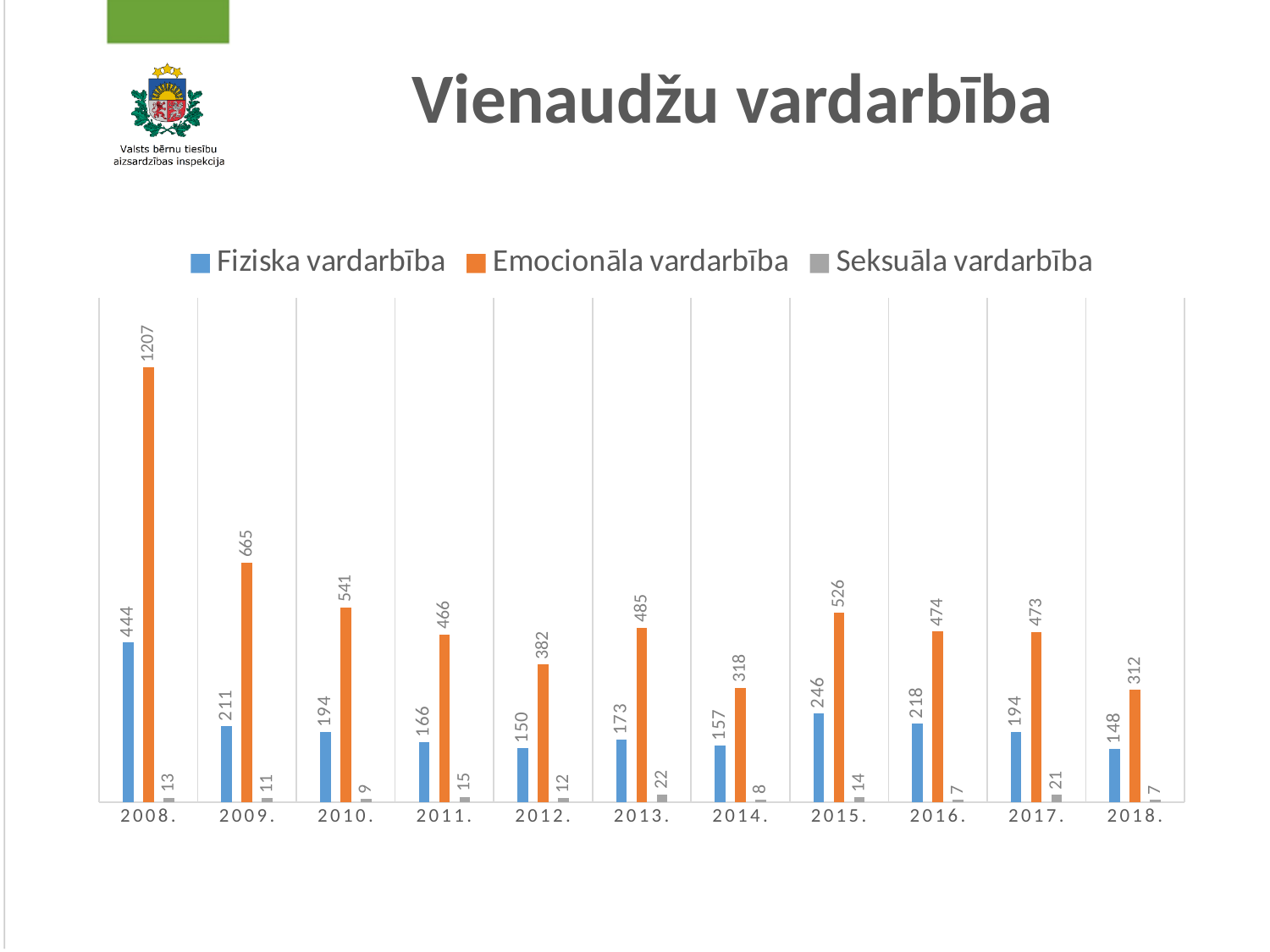
What kind of chart is shown on the slide? bar chart Which colour represents Seksuāla vardarbība in the chart? grey In which year is Emocionāla vardarbība highest? 2008. What is the value for Emocionāla vardarbība in 2008? 1207 Which is larger: Fiziska vardarbība in 2009 or Fiziska vardarbība in 2016? Fiziska vardarbība in 2016 In which year is Fiziska vardarbība lowest? 2018. How many years are shown on the x axis? 11 What is the difference between Emocionāla vardarbība and Fiziska vardarbība in 2018? 164 What is the value for Seksuāla vardarbība in 2013? 22 What is the title of the slide? Vienaudžu vardarbība What is the value for Fiziska vardarbība in 2015? 246 How many series does the legend list? 3